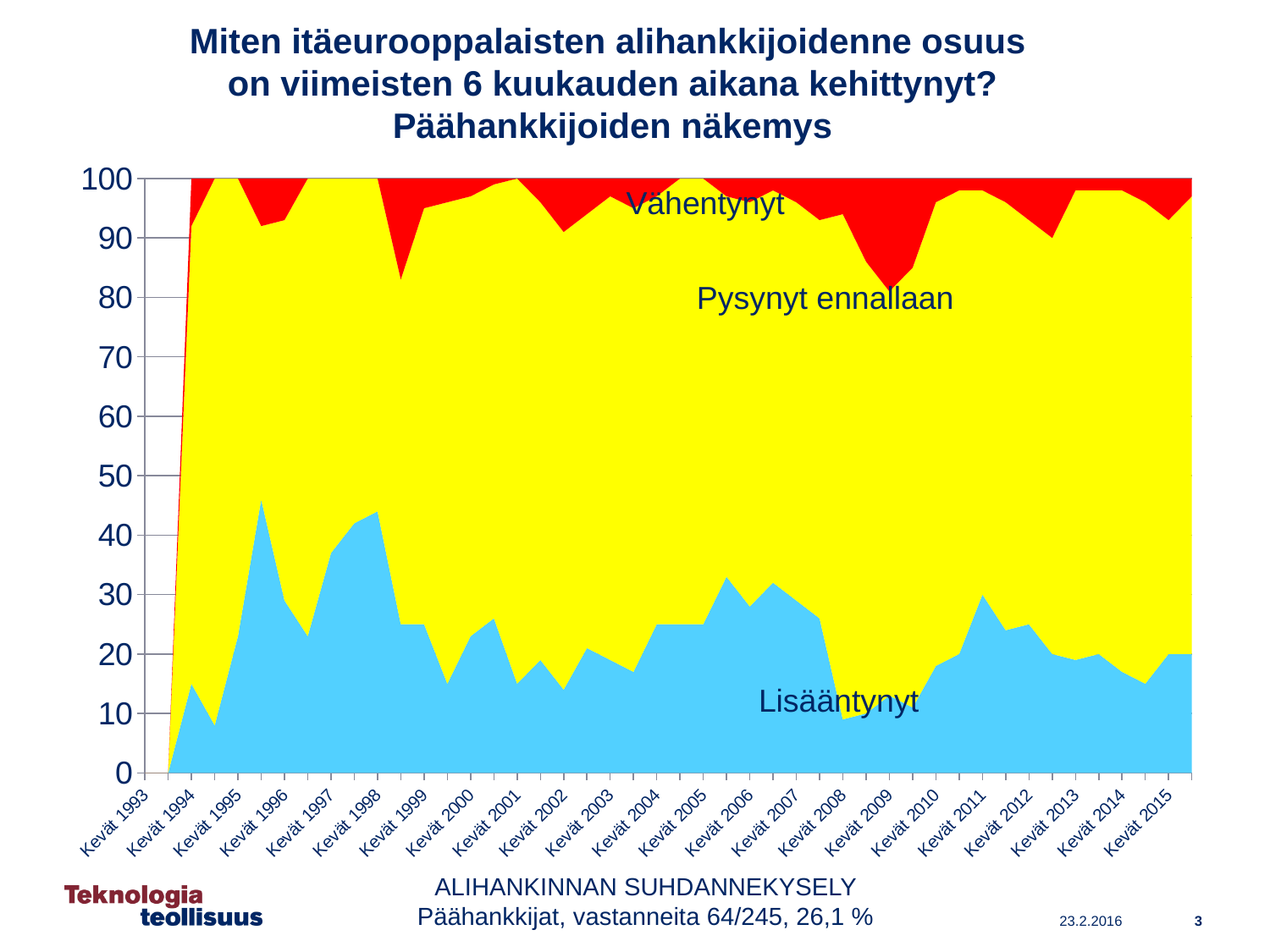
Is the value for Lisääntynyt at Kevät 2008 larger or smaller than at Kevät 2006? smaller What kind of chart is shown on the slide? Stacked area chart Which series occupies the largest share of the chart area across the years? Pysynyt ennallaan What is the last category label on the x axis? Kevät 2015 How many series are plotted in the chart? 3 Is the value for Lisääntynyt at Kevät 1995 larger or smaller than at Kevät 2002? larger Is the value for Lisääntynyt at Kevät 2008 greater or less than 20? less Is the value for Lisääntynyt at Kevät 1995 greater or less than 40? less What is the first category label on the x axis? Kevät 1993 Is the value for Lisääntynyt at Kevät 2002 greater or less than 20? less How many labelled categories are shown on the x axis? 23